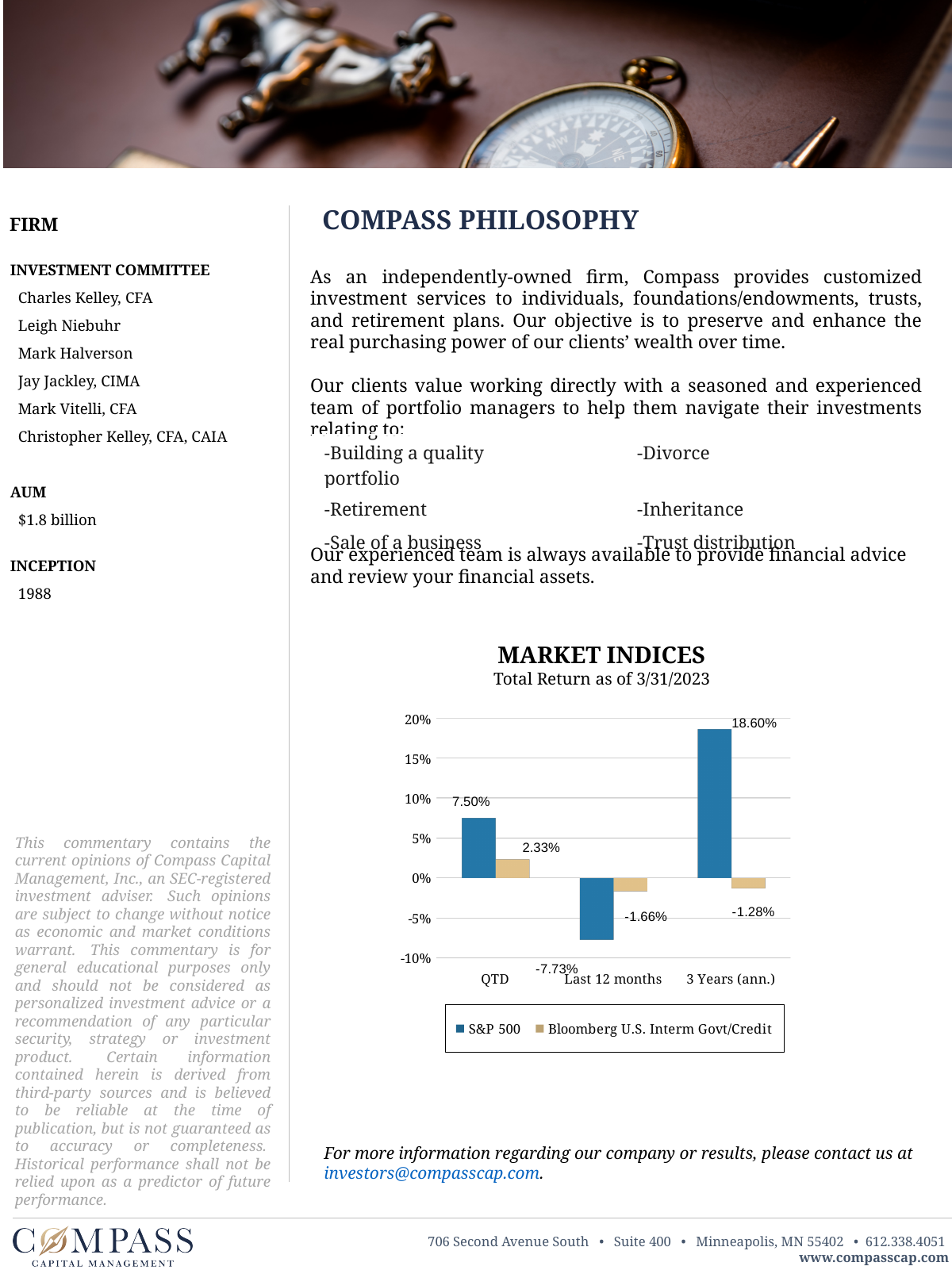
In the Market Indices chart, which is larger for Last 12 months: the S&P 500 value or the Bloomberg U.S. Interm Govt/Credit value? Bloomberg U.S. Interm Govt/Credit What is the Bloomberg U.S. Interm Govt/Credit value for 3 Years (ann.) in the Market Indices chart? -1.28% What kind of chart is the Market Indices chart? Bar chart What is the Bloomberg U.S. Interm Govt/Credit value for Last 12 months in the Market Indices chart? -1.66% How many series does the legend of the Market Indices chart list? 2 How many periods are shown on the x axis of the Market Indices chart? 3 In the Market Indices chart, which period has the highest S&P 500 return? 3 Years (ann.) What is the S&P 500 value for 3 Years (ann.) in the Market Indices chart? 18.60% In the Market Indices chart, which period has the lowest S&P 500 return? Last 12 months In the Market Indices chart, what is the difference between the S&P 500 and Bloomberg U.S. Interm Govt/Credit values for QTD? 5.17% What is the subtitle shown under the Market Indices chart title? Total Return as of 3/31/2023 What is the S&P 500 value for QTD in the Market Indices chart? 7.50%